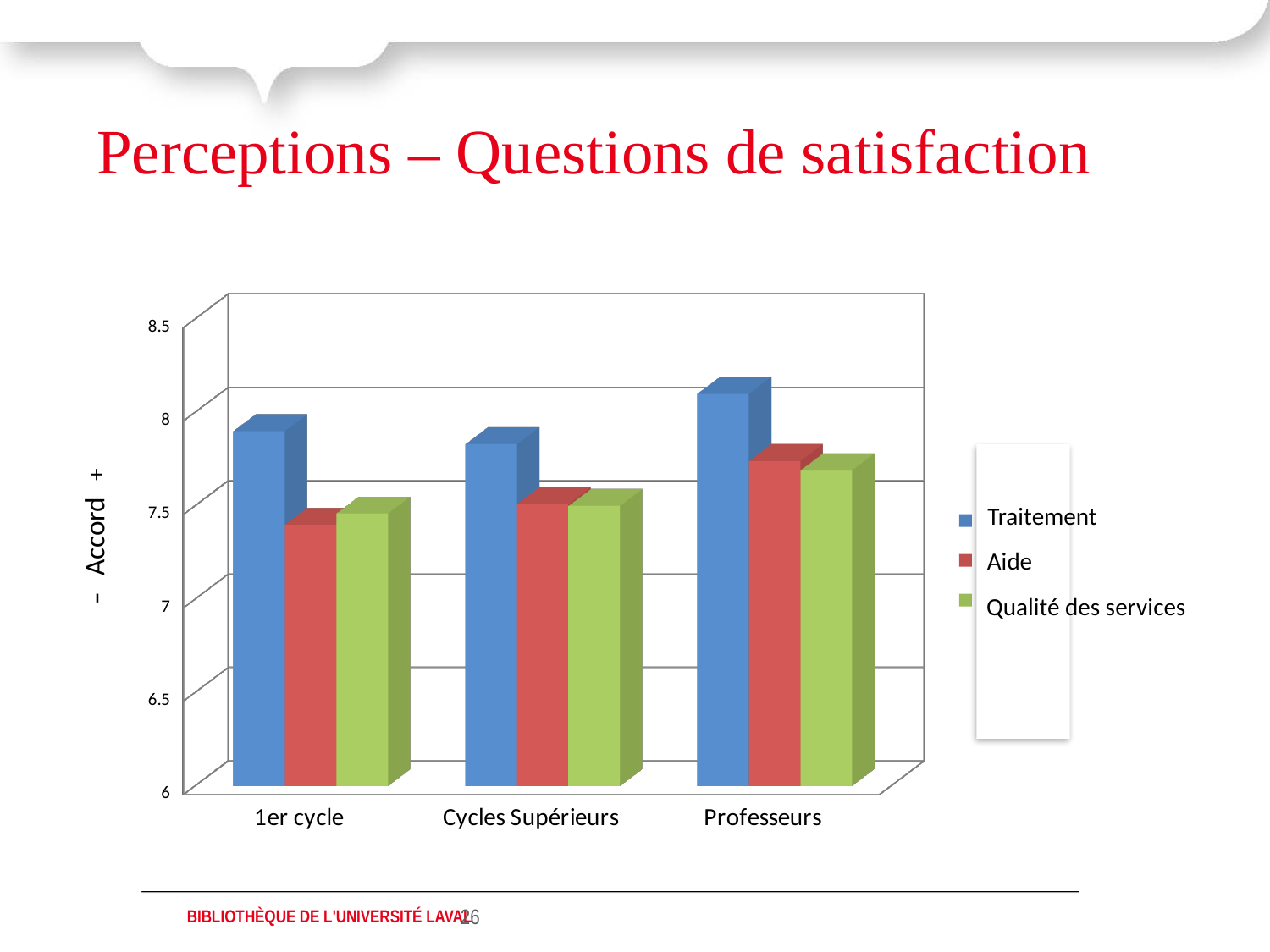
How many categories are shown on the x axis of the chart? 3 What is the label on the vertical axis of the chart? - Accord + Do the Aide values rise or fall from 1er cycle to Professeurs? rise How many series does the chart's legend list? 3 Is the Aide value for Professeurs greater or less than 7.5? greater What kind of chart is shown on the slide? bar chart Which series has the highest value for Professeurs? Traitement Is the Traitement value for Professeurs greater or less than 8? greater Which is larger, the Aide value for Professeurs or the Aide value for 1er cycle? Professeurs Which category has the highest Traitement value? Professeurs Which series has the highest value for 1er cycle? Traitement Is the Traitement value for Cycles Supérieurs greater or less than 7.5? greater